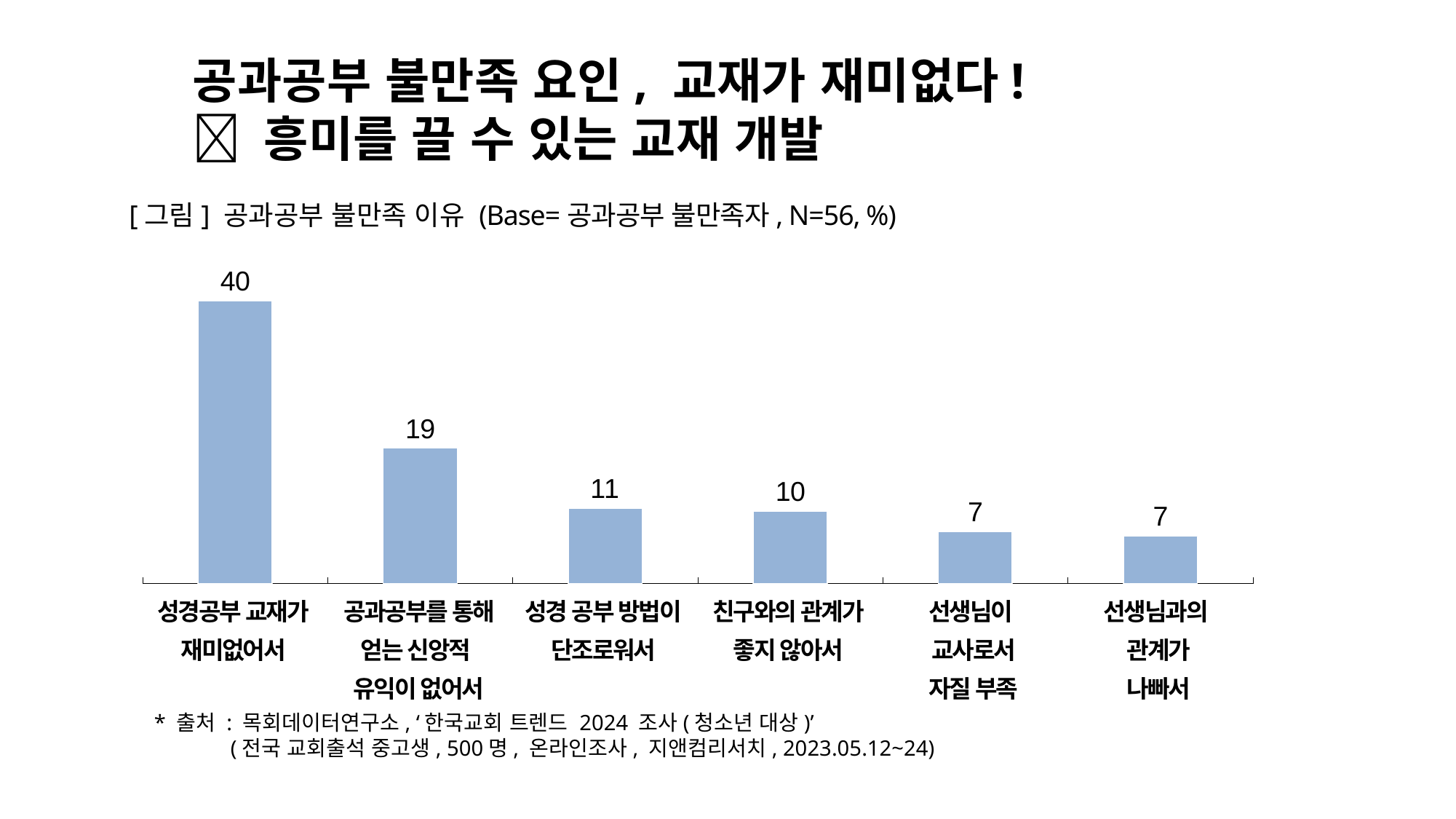
What is the difference between the values for 성경공부 교재가 재미없어서 and 공과공부를 통해 얻는 신앙적 유익이 없어서? 21 What is the value for 공과공부를 통해 얻는 신앙적 유익이 없어서? 19 Do the values rise or fall from left to right across the categories? fall What is the value for 성경공부 교재가 재미없어서? 40 What is the value for 친구와의 관계가 좋지 않아서? 10 What is the difference between the values for 성경 공부 방법이 단조로워서 and 선생님과의 관계가 나빠서? 4 Which is larger, the value for 성경 공부 방법이 단조로워서 or the value for 친구와의 관계가 좋지 않아서? 성경 공부 방법이 단조로워서 What is the value for 선생님이 교사로서 자질 부족? 7 What is the base size (N) stated in the chart caption? N=56 What kind of chart is shown on the slide? bar chart Which category has the highest value? 성경공부 교재가 재미없어서 How many categories are shown in the chart? 6